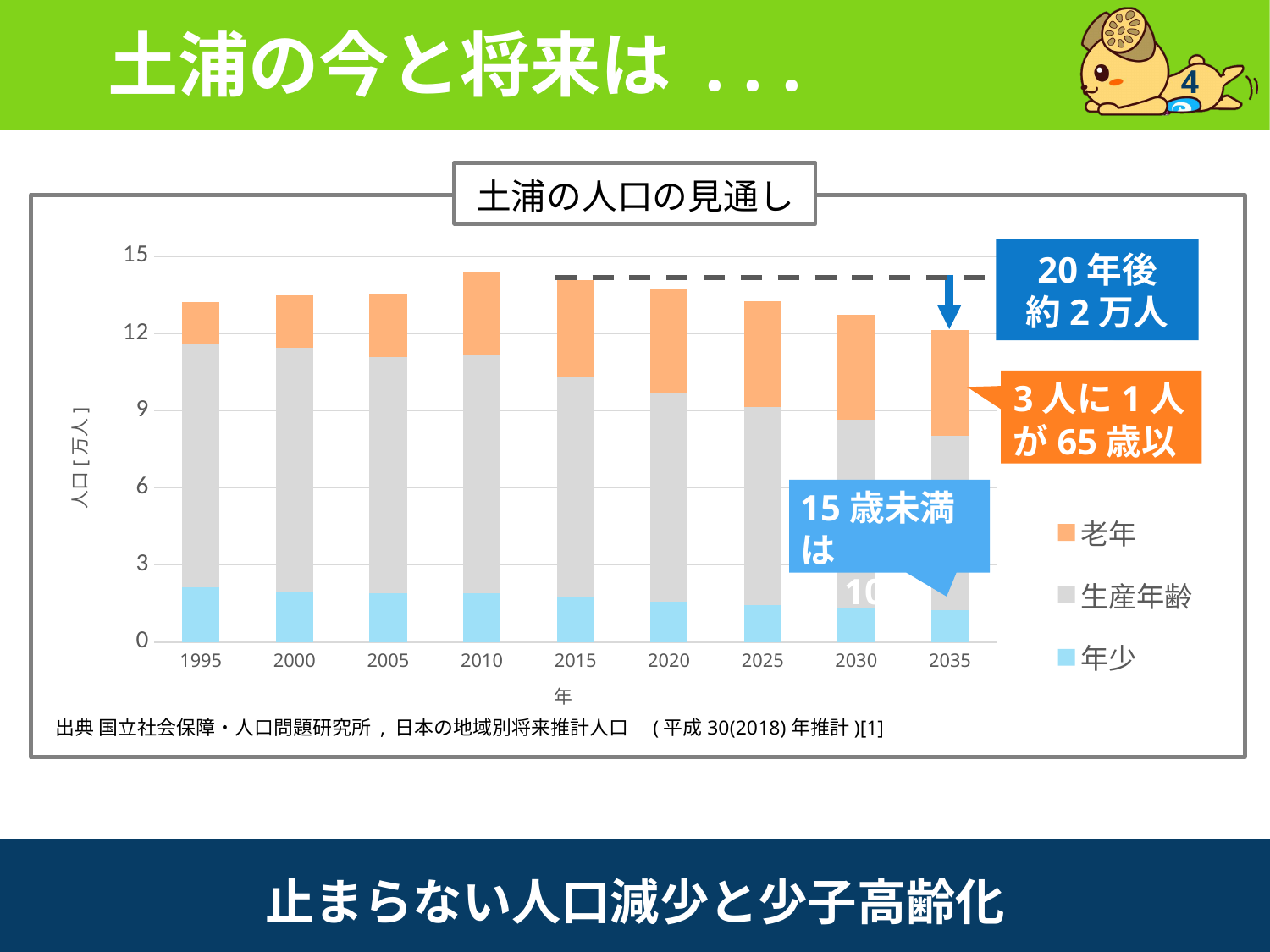
What is the title of the chart? 土浦の人口の見通し Is the 年少 segment for 1995 greater or less than 3? less Which is larger, the total population bar for 2010 or for 2035? 2010 What kind of chart is shown on the slide? stacked bar chart From 2015 to 2035, do the total population bars rise or fall? fall Which year has the highest total population bar? 2010 How many series does the legend list? 3 What are the three series listed in the legend? 老年, 生産年齢, 年少 Is the total population bar for 1995 greater or less than 12? greater Is the total population bar for 2035 greater or less than 15? less Which year has the lowest total population bar? 2035 How many years are shown on the x axis? 9